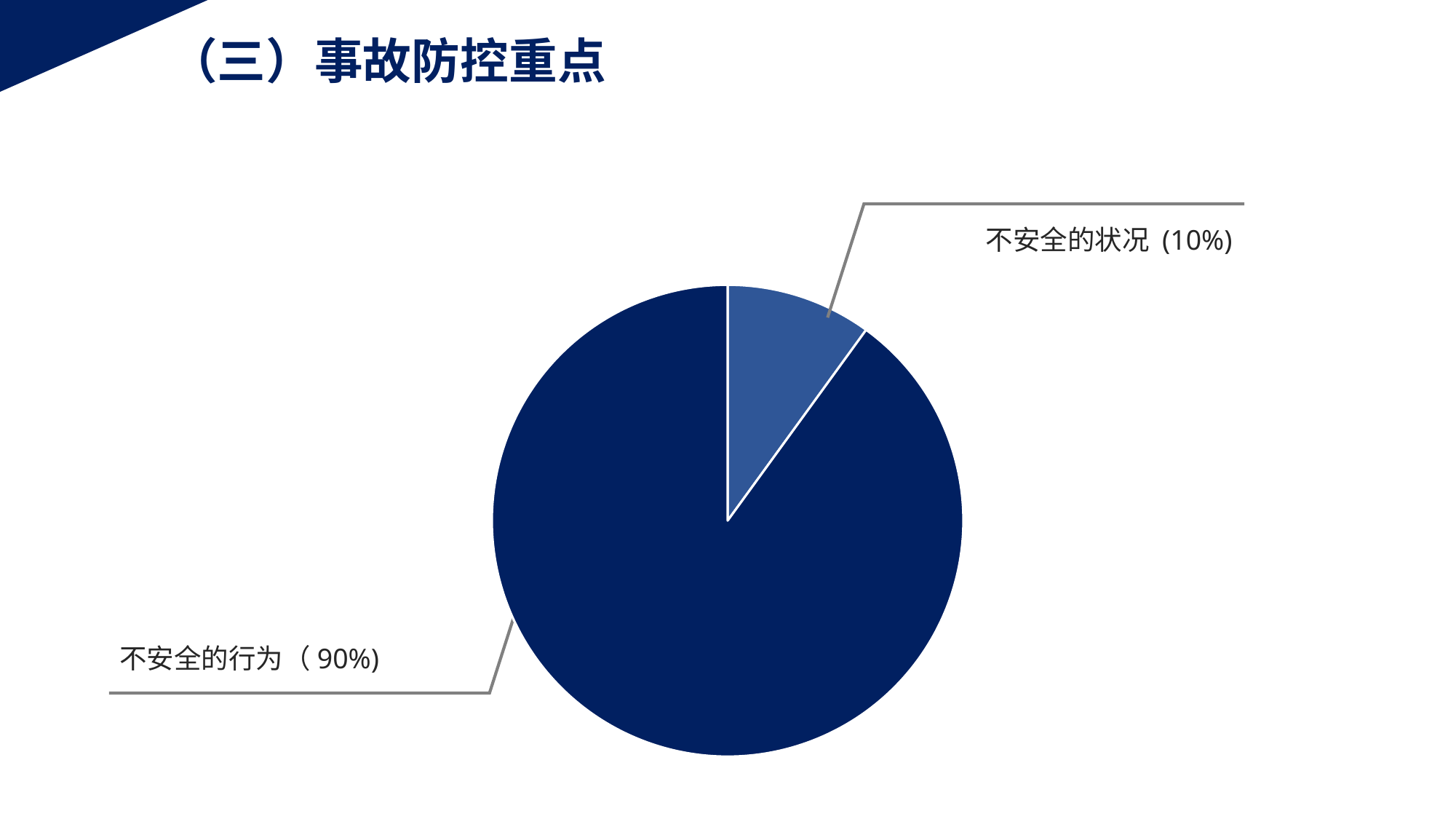
What kind of chart is shown on the slide? pie chart What is the title of the slide containing the pie chart? （三）事故防控重点 What share of the pie does 不安全的行为 account for? 90% What is the combined share of the two slices in the pie chart? 100% Which slice of the pie is the smallest? 不安全的状况 Which slice of the pie is the largest? 不安全的行为 What share of the pie does 不安全的状况 account for? 10% What is the difference in percentage points between 不安全的行为 and 不安全的状况? 80 Which is larger, the share for 不安全的行为 or the share for 不安全的状况? 不安全的行为 How many slices does the pie chart have? 2 Which slice is drawn in the lighter blue colour? 不安全的状况